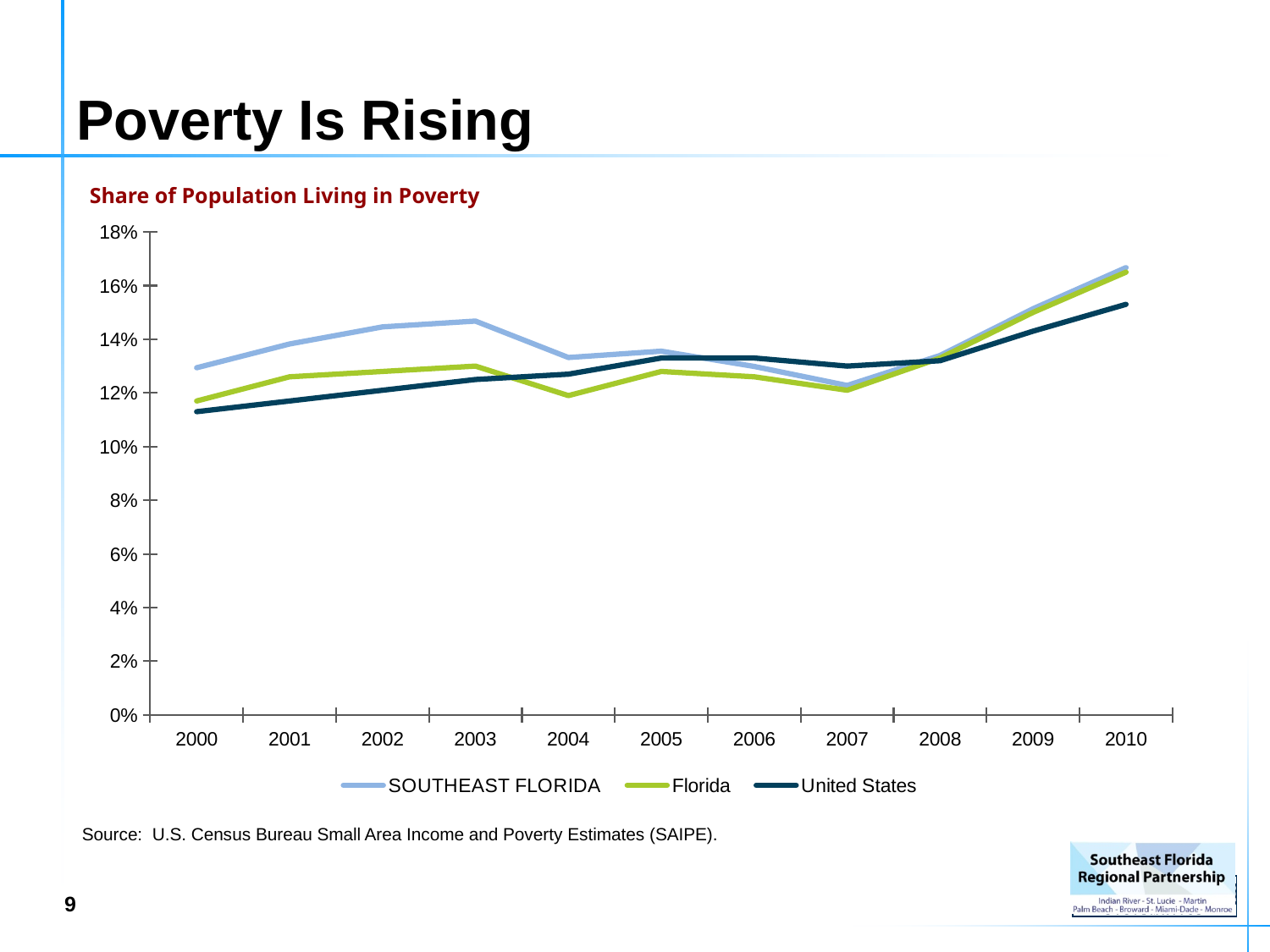
Is the value for SOUTHEAST FLORIDA in 2010 greater or less than 16%? greater How many series does the legend list? 3 What is the title of the chart? Share of Population Living in Poverty Is the value for SOUTHEAST FLORIDA in 2003 greater or less than 14%? greater In 2004, which is larger: Florida or United States? United States How many years are plotted along the x axis? 11 Is the value for United States in 2000 greater or less than 12%? less In 2000, which is larger: SOUTHEAST FLORIDA or United States? SOUTHEAST FLORIDA In which year is the SOUTHEAST FLORIDA series at its highest? 2010 Does the United States series rise or fall overall from 2000 to 2010? rise What kind of chart is shown on the slide? line chart